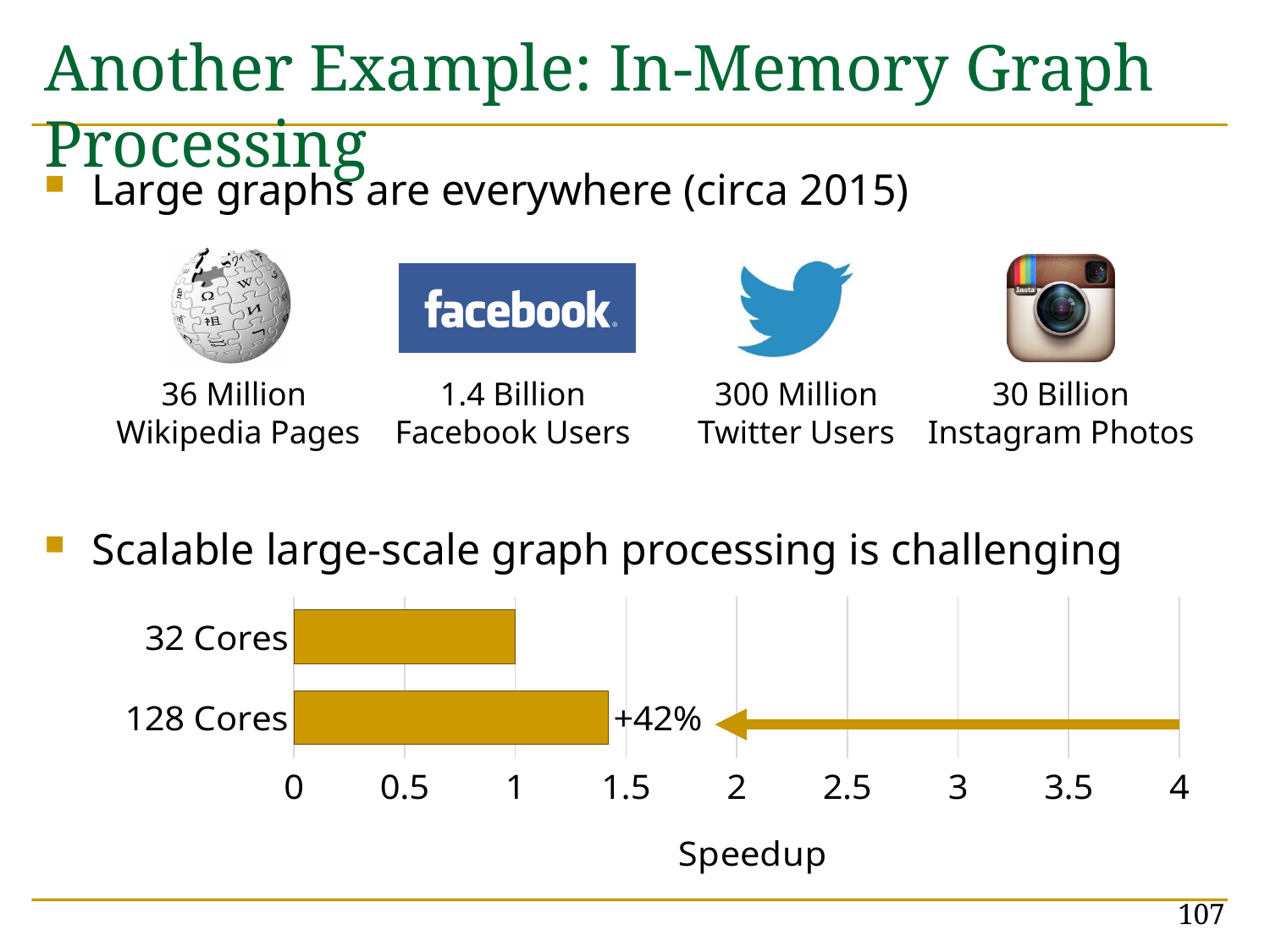
What annotation is printed next to the 128 Cores bar? +42% What is the title of the horizontal axis of the chart? Speedup Is the speedup for 128 Cores greater or less than 1? greater Which category has the highest speedup? 128 Cores Which has a larger speedup, 32 Cores or 128 Cores? 128 Cores What is the maximum value shown on the horizontal axis of the chart? 4 Which category has the lowest speedup? 32 Cores Is the speedup for 128 Cores greater or less than 1.5? less Is the speedup for 32 Cores greater or less than 2? less What kind of chart is shown on the slide? bar chart How many categories are plotted in the bar chart? 2 What is the speedup value for 32 Cores? 1